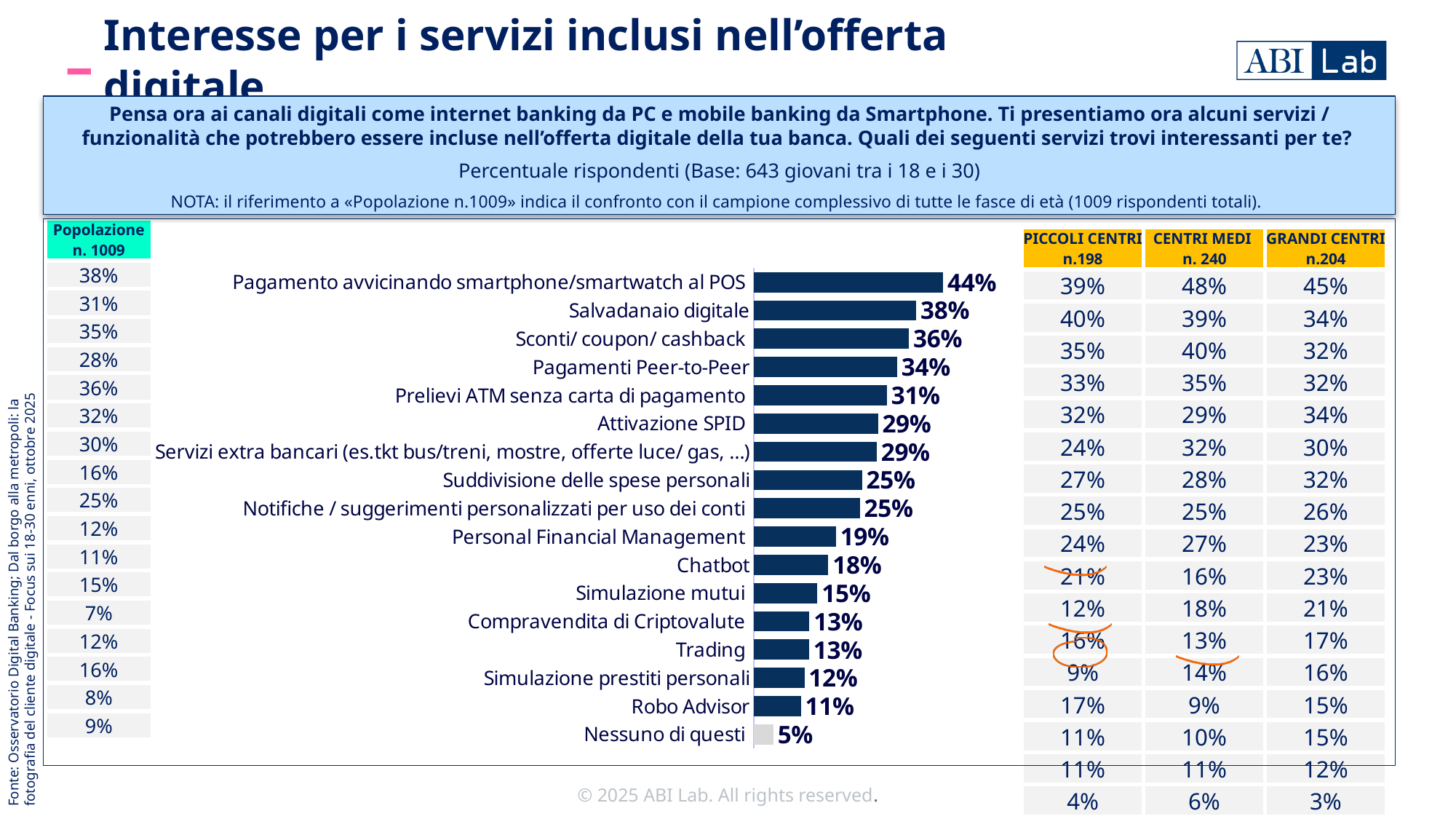
How many categories (bars) are shown in the bar chart? 17 What kind of chart is shown on the slide? Bar chart Which service has the highest percentage in the bar chart? Pagamento avvicinando smartphone/smartwatch al POS Which bar in the chart is coloured differently (grey) from the dark blue bars? Nessuno di questi Which has a higher value, 'Chatbot' or 'Simulazione mutui'? Chatbot What percentage of respondents find 'Salvadanaio digitale' interesting? 38% What is the difference in percentage points between 'Pagamento avvicinando smartphone/smartwatch al POS' and 'Salvadanaio digitale'? 6 percentage points Which category has the lowest value in the bar chart? Nessuno di questi Do the bar values increase or decrease going from the top of the chart to the bottom? Decrease What is the value shown for 'Attivazione SPID'? 29% What is the value shown for 'Robo Advisor'? 11% What is the value shown for 'Prelievi ATM senza carta di pagamento'? 31%